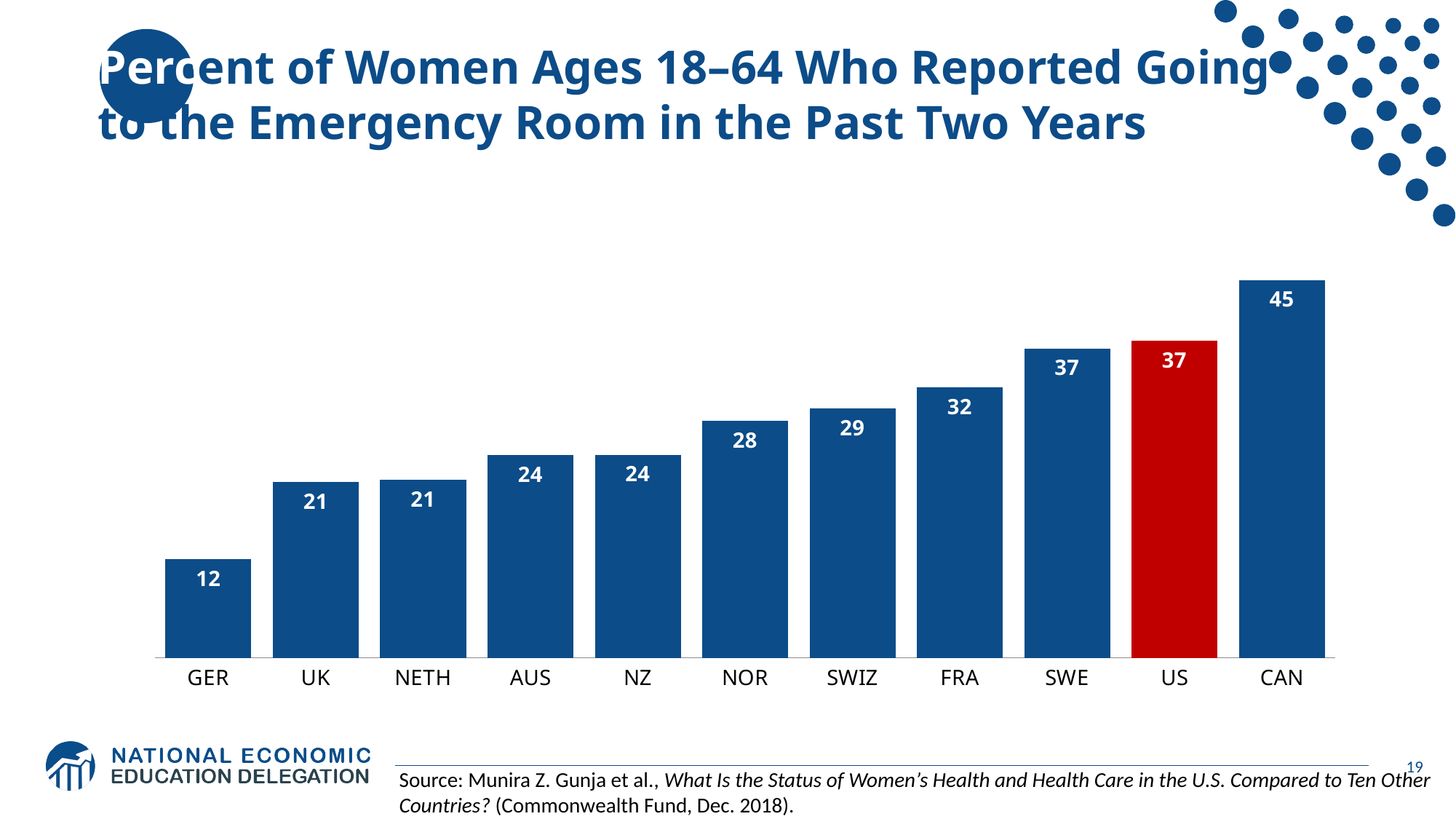
What is the value for the US? 37 What is the value for NOR? 28 What is the difference between the values for FRA and GER? 20 What is the difference between the values for CAN and the US? 8 Do the values rise or fall from left to right across the chart? rise How many countries are shown in the chart? 11 Which country has the highest value? CAN What kind of chart is shown on the slide? bar chart Which is larger, the value for SWIZ or the value for AUS? SWIZ Which country has the lowest value? GER What is the value for GER? 12 Which country's bar is coloured red? US